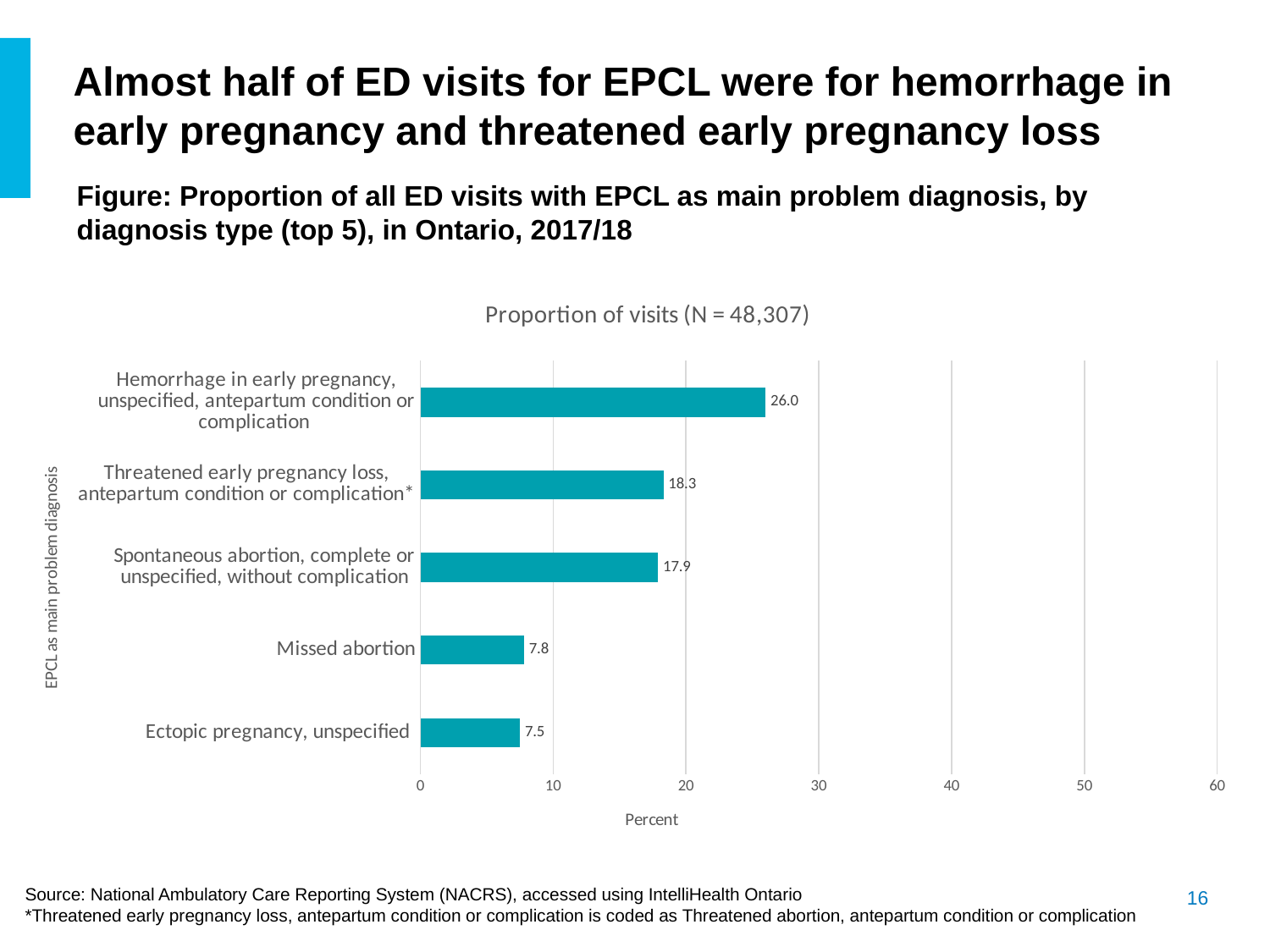
Which diagnosis has the highest proportion of visits? Hemorrhage in early pregnancy, unspecified, antepartum condition or complication What is the title of the chart? Proportion of visits (N = 48,307) Which is larger, the value for Missed abortion or the value for Ectopic pregnancy, unspecified? Missed abortion What is the value for Ectopic pregnancy, unspecified? 7.5 How many diagnosis categories are shown in the chart? 5 Which diagnosis has the lowest proportion of visits? Ectopic pregnancy, unspecified What is the difference between the values for Hemorrhage in early pregnancy, unspecified, antepartum condition or complication and Threatened early pregnancy loss, antepartum condition or complication*? 7.7 What is the label of the horizontal axis? Percent Is the value for Hemorrhage in early pregnancy, unspecified, antepartum condition or complication greater or less than 20? greater What is the value for Spontaneous abortion, complete or unspecified, without complication? 17.9 What kind of chart is shown on the slide? bar chart What is the value for Missed abortion? 7.8